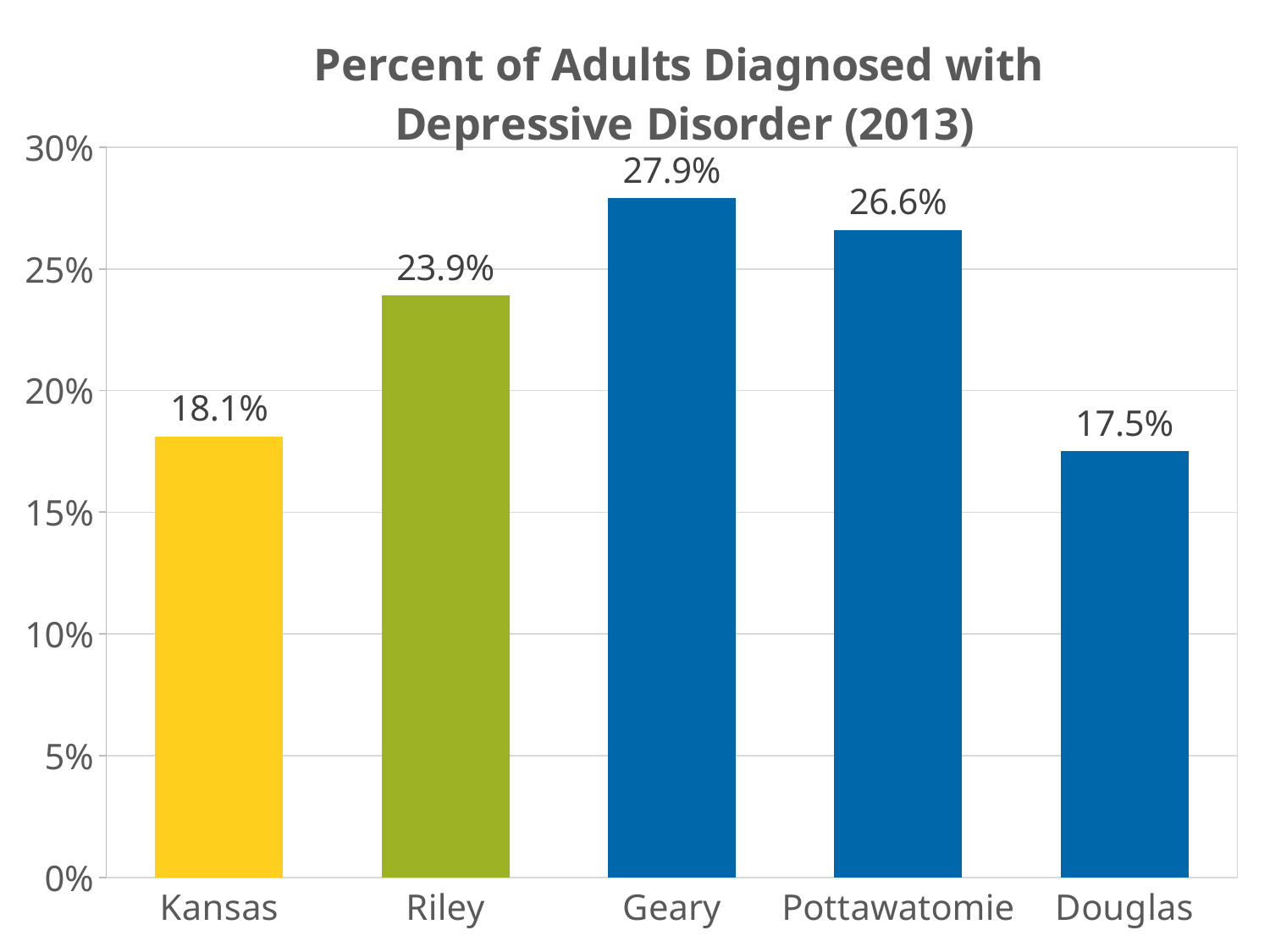
What is the value for Geary? 27.9% Which category has the lowest value? Douglas Which is larger, the value for Riley or the value for Pottawatomie? Pottawatomie What is the value for Kansas? 18.1% What is the difference between the values for Geary and Kansas? 9.8% What is the value for Riley? 23.9% How many categories are shown on the chart? 5 What kind of chart is this? Bar chart What is the title of the chart? Percent of Adults Diagnosed with Depressive Disorder (2013) Which category has the highest value? Geary What is the value for Pottawatomie? 26.6% What is the value for Douglas? 17.5%